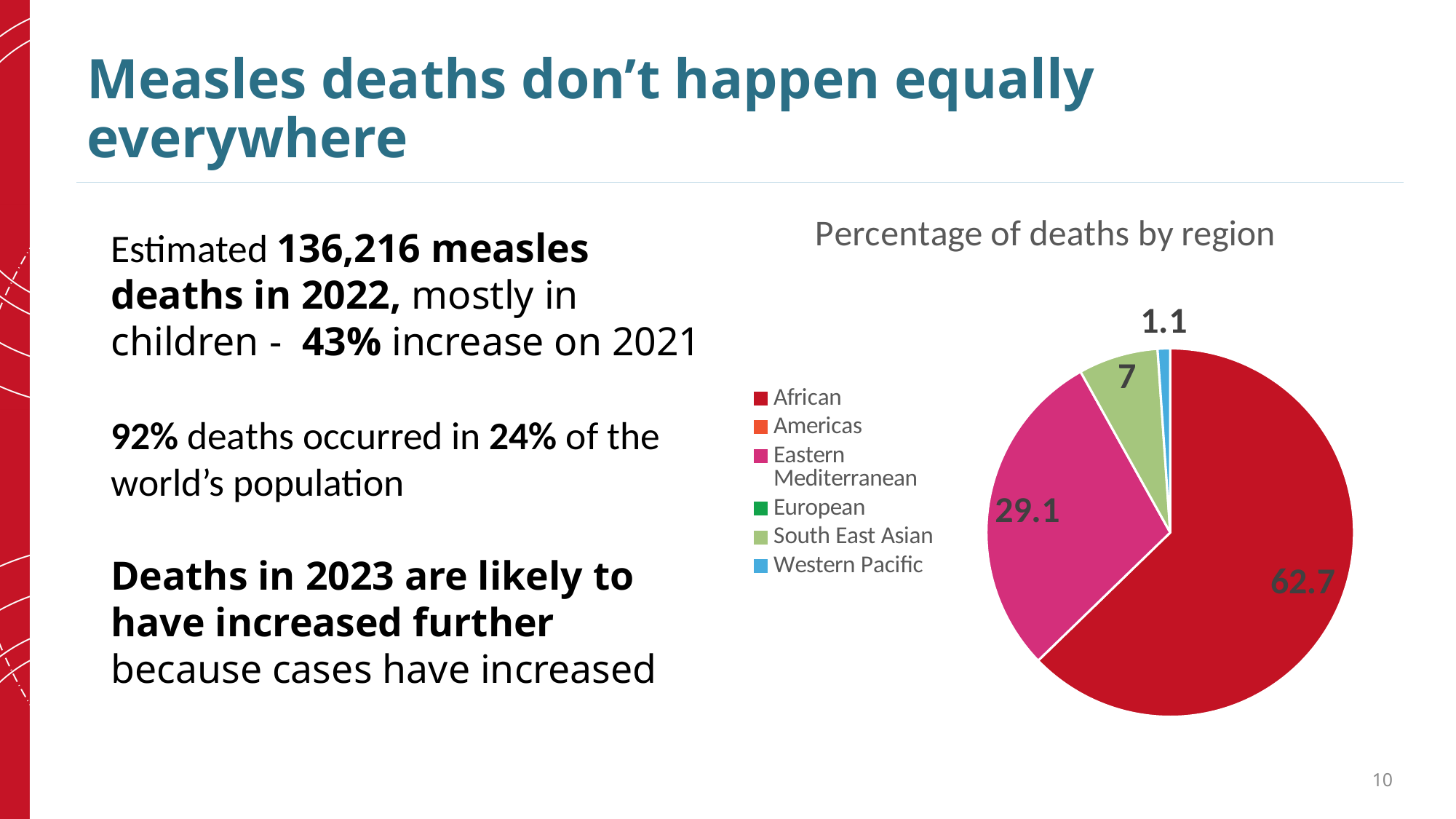
How many regions are listed in the legend of the pie chart? 6 Which is larger in the pie chart, the Eastern Mediterranean slice or the South East Asian slice? Eastern Mediterranean What kind of chart is shown on the slide? Pie chart What value is labelled for the South East Asian slice of the pie chart? 7 Which region has the largest share of deaths in the pie chart? African What is the difference between the South East Asian and Western Pacific values in the pie chart? 5.9 What is the difference between the African and Eastern Mediterranean values in the pie chart? 33.6 What percentage of measles deaths is shown for the African region in the pie chart? 62.7 What colour is the African slice in the pie chart? Red What is the title of the chart on the slide? Percentage of deaths by region What value is labelled for the Eastern Mediterranean slice of the pie chart? 29.1 What value is labelled for the Western Pacific slice of the pie chart? 1.1